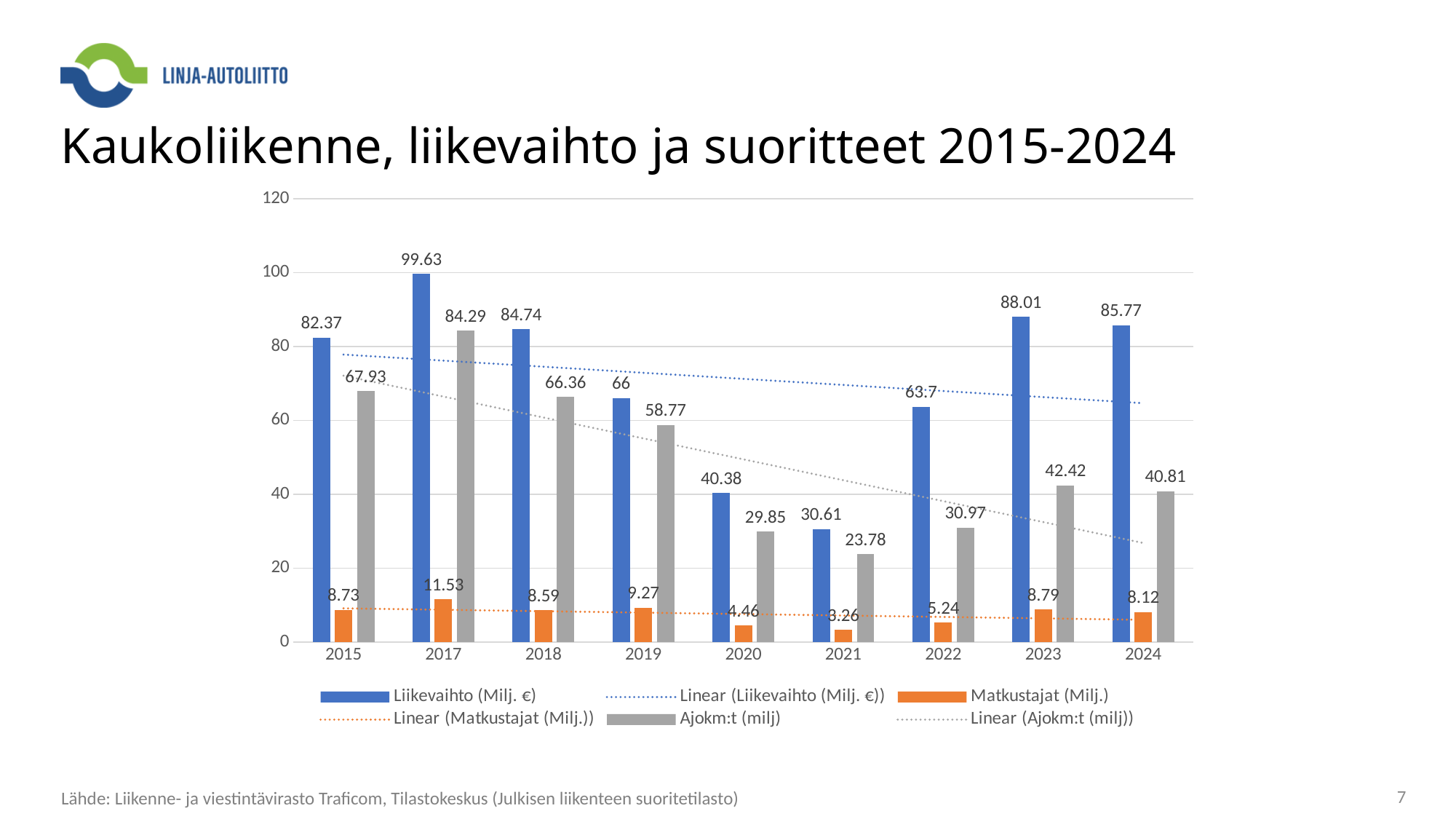
What is the Matkustajat (Milj.) value for 2021? 3.26 Do the Ajokm:t (milj) values rise or fall from 2015 to 2021? Fall In which year is Matkustajat (Milj.) lowest? 2021 What is the title of the chart on the slide? Kaukoliikenne, liikevaihto ja suoritteet 2015-2024 Which year has the larger Ajokm:t (milj) value, 2023 or 2024? 2023 What is the Liikevaihto (Milj. €) value for 2017? 99.63 What is the difference between the Liikevaihto (Milj. €) values for 2023 and 2022? 24.31 How many years are shown on the x axis? 9 In which year is Liikevaihto (Milj. €) highest? 2017 How many entries does the legend list? 6 What kind of chart is shown on the slide? Bar chart What is the Ajokm:t (milj) value for 2019? 58.77